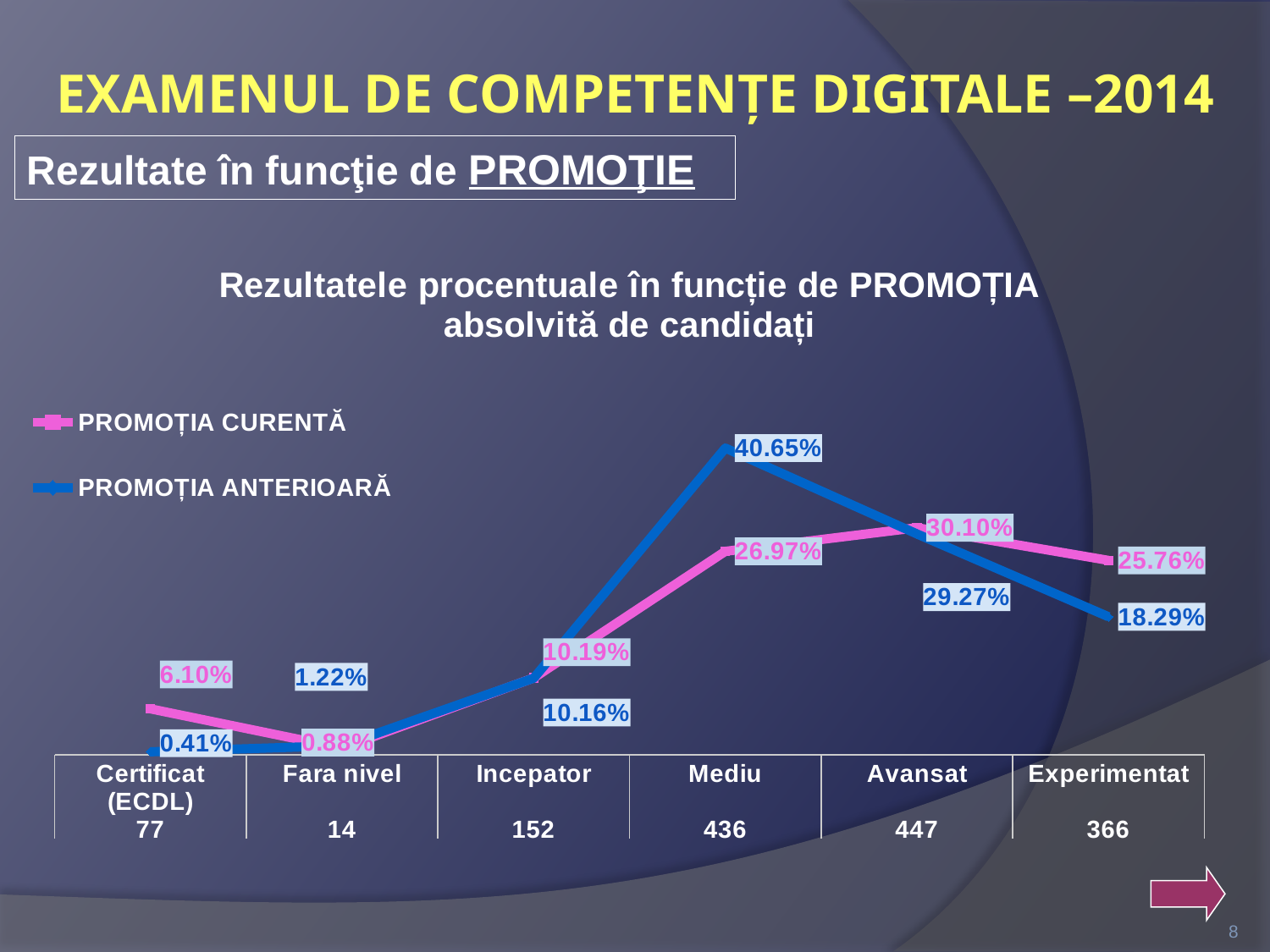
What type of chart is shown on the slide? line chart At Experimentat, which series has the larger value, PROMOȚIA CURENTĂ or PROMOȚIA ANTERIOARĂ? PROMOȚIA CURENTĂ Which category has the lowest value for PROMOȚIA CURENTĂ? Fara nivel What is the value for PROMOȚIA ANTERIOARĂ at Mediu? 40.65% What is the difference between PROMOȚIA ANTERIOARĂ and PROMOȚIA CURENTĂ at Mediu? 13.68% How many series does the legend list? 2 What is the value for PROMOȚIA ANTERIOARĂ at Experimentat? 18.29% What number is shown under the Avansat category label? 447 Which category has the highest value for PROMOȚIA ANTERIOARĂ? Mediu What is the value for PROMOȚIA CURENTĂ at Avansat? 30.10% How many categories are shown on the x axis? 6 What is the value for PROMOȚIA CURENTĂ at Certificat (ECDL)? 6.10%